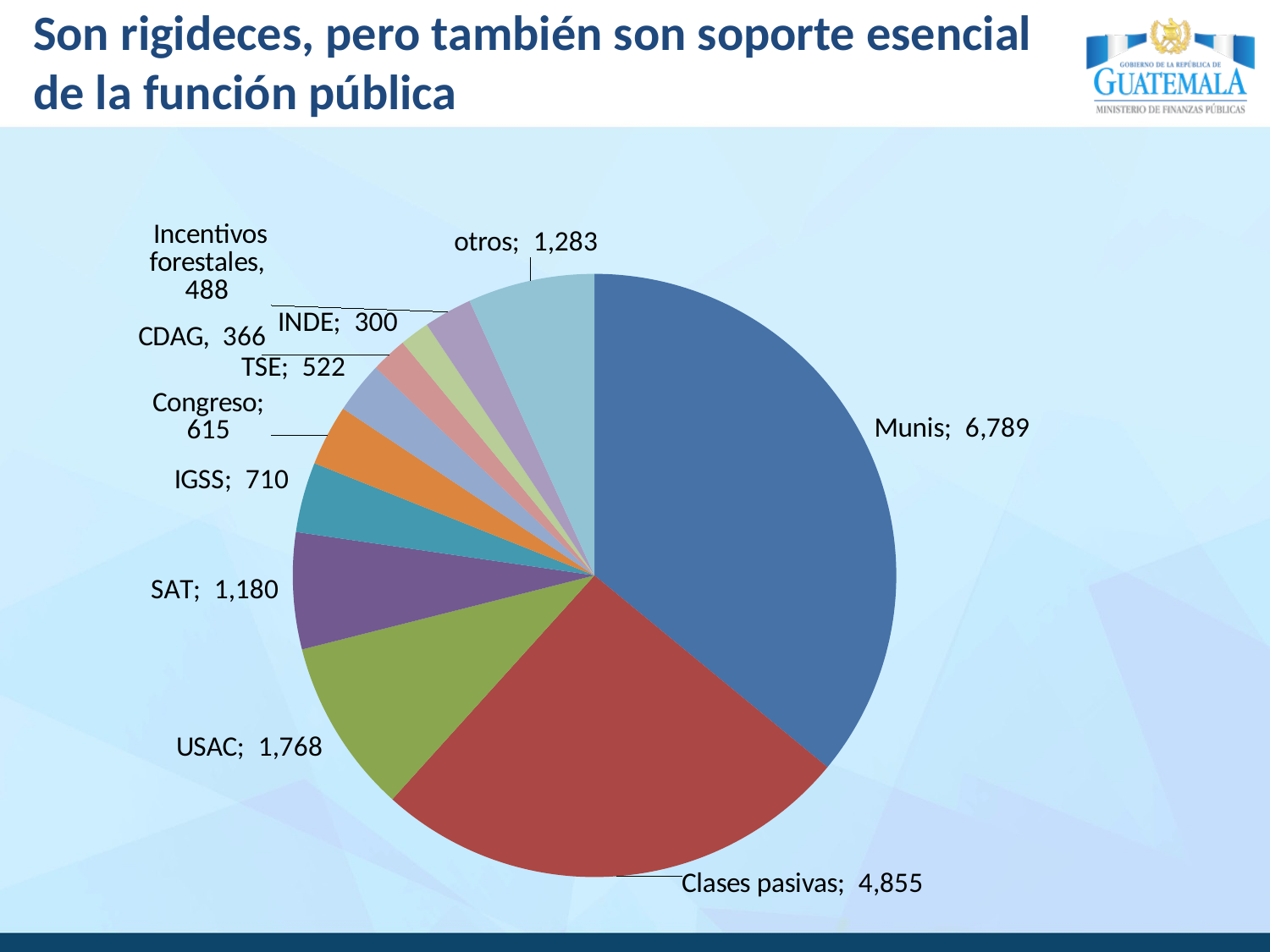
What type of chart is shown on the slide? pie chart Which category has the smallest slice? INDE How many slices does the pie chart have? 11 What is the difference between the values for Munis and Clases pasivas? 1,934 What is the value for Clases pasivas? 4,855 What is the value for USAC? 1,768 Which category has the largest slice? Munis Which is larger, the value for IGSS or the value for Congreso? IGSS What is the difference between the values for USAC and SAT? 588 What is the value for Incentivos forestales? 488 What is the value for otros? 1,283 What is the value for Munis? 6,789